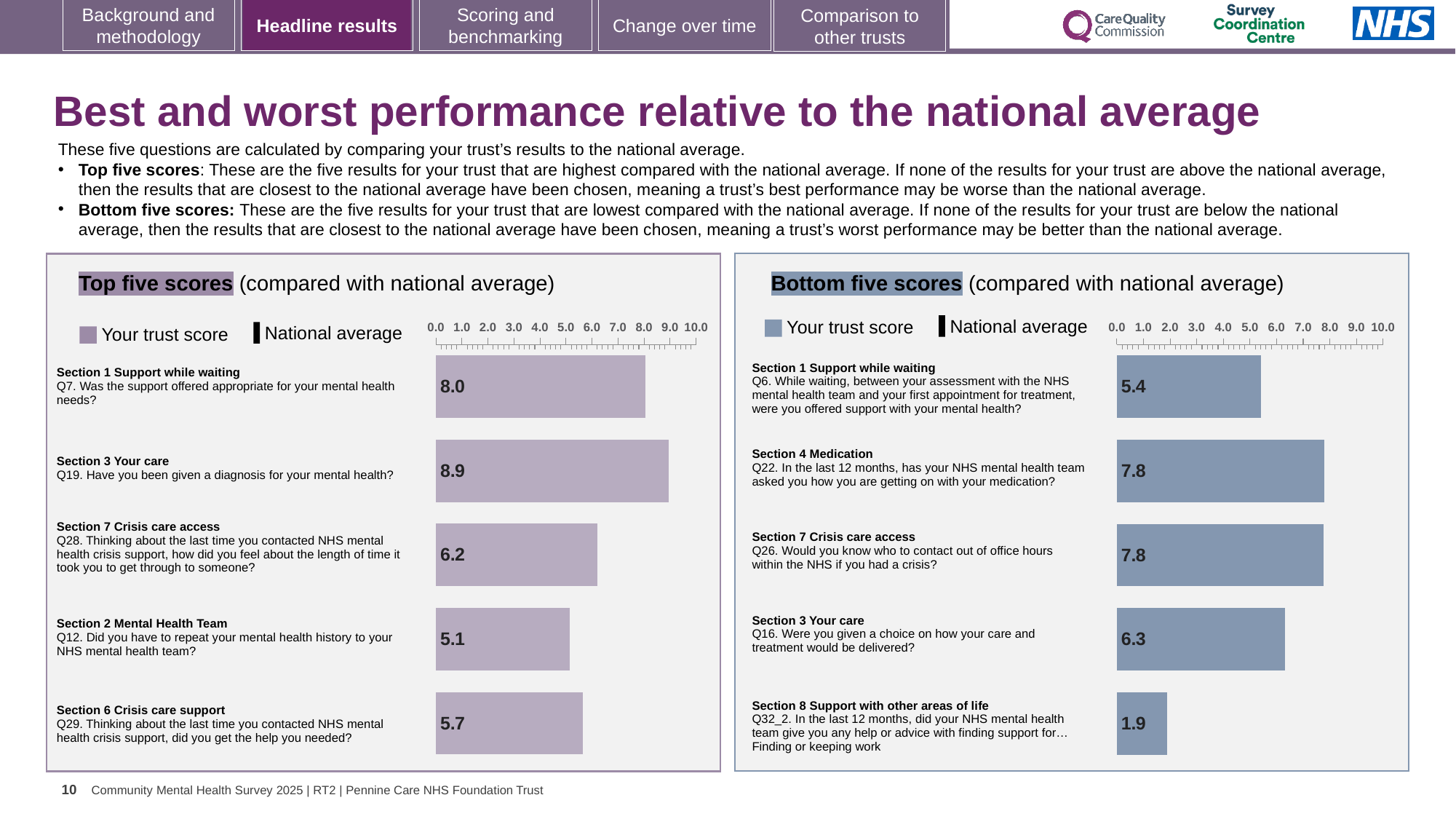
In the 'Top five scores' chart, what is the trust score for Q12 (Did you have to repeat your mental health history to your NHS mental health team?)? 5.1 In the 'Bottom five scores' chart, which question has the lowest trust score? Q32_2 In the 'Top five scores' chart, what is the trust score for Q19 (Have you been given a diagnosis for your mental health?)? 8.9 What type of chart is the 'Top five scores' chart? Bar chart In the 'Bottom five scores' chart, what is the trust score for Q32_2 (help or advice with finding or keeping work)? 1.9 In the 'Top five scores' chart, what is the difference between the trust scores for Q7 and Q28? 1.8 In the 'Bottom five scores' chart, what is the trust score for Q6 (support while waiting between assessment and first appointment)? 5.4 How many bars are plotted in the 'Bottom five scores' chart? 5 How many entries does the legend of the 'Bottom five scores' chart list? 2 In the 'Bottom five scores' chart, what is the difference between the trust scores for Q22 and Q16? 1.5 In the 'Top five scores' chart, which question has the highest trust score? Q19 In the 'Top five scores' chart, which has the larger trust score, Q29 or Q12? Q29